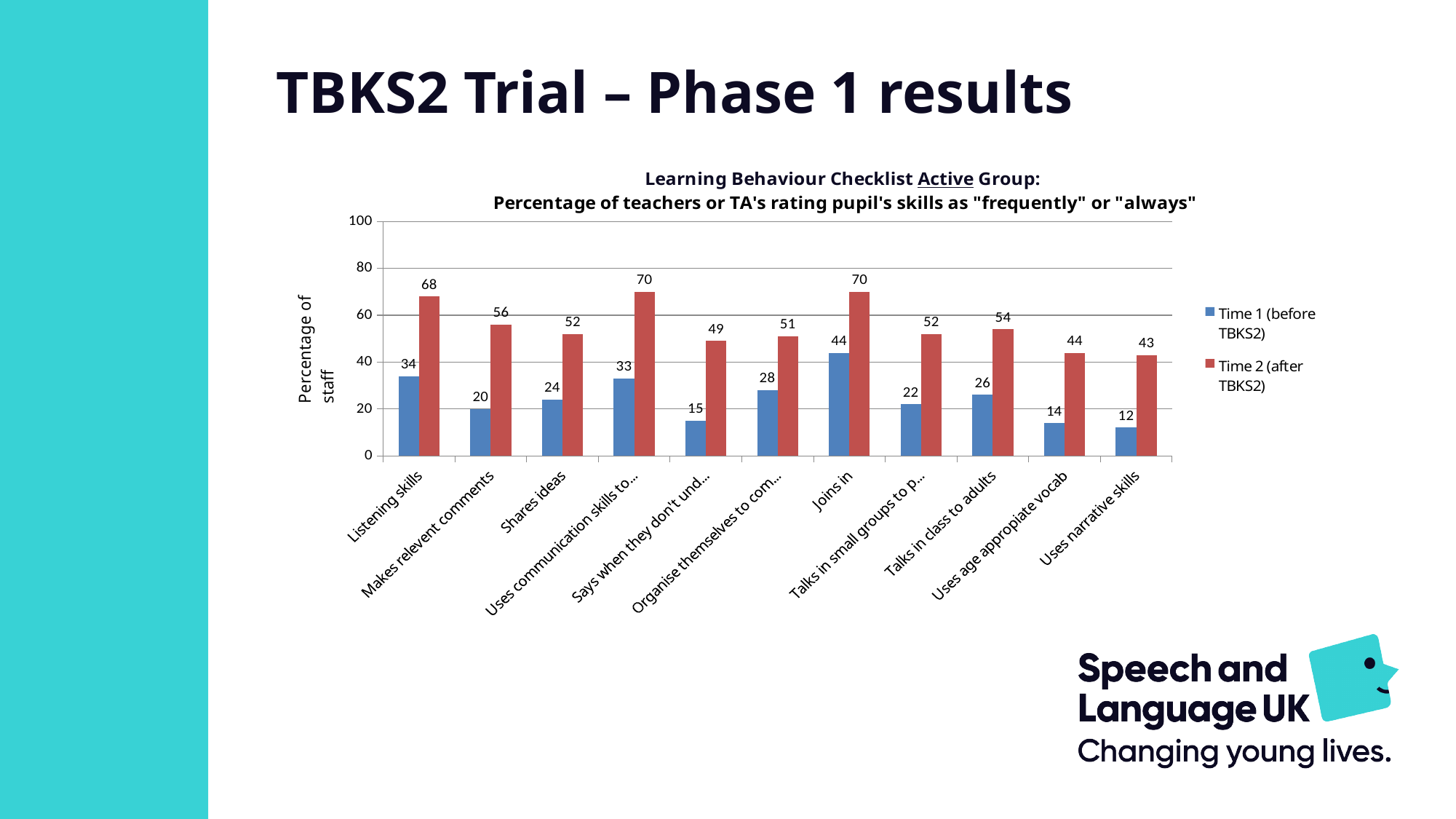
Which is larger: the Time 1 value for Joins in or the Time 1 value for Listening skills? Joins in What is the Time 2 (after TBKS2) value for Talks in class to adults? 54 How many categories are shown on the x axis? 11 What is the difference between the Time 2 and Time 1 values for Makes relevent comments? 36 Which category has the highest Time 1 (before TBKS2) value? Joins in Is the Time 2 (after TBKS2) value for Uses age appropiate vocab greater or less than 40? greater What type of chart is shown on the slide? Bar chart Which category has the lowest Time 1 (before TBKS2) value? Uses narrative skills What is the label of the vertical axis? Percentage of staff What is the Time 1 (before TBKS2) value for Shares ideas? 24 What is the Time 2 (after TBKS2) value for Listening skills? 68 How many series does the legend list? 2